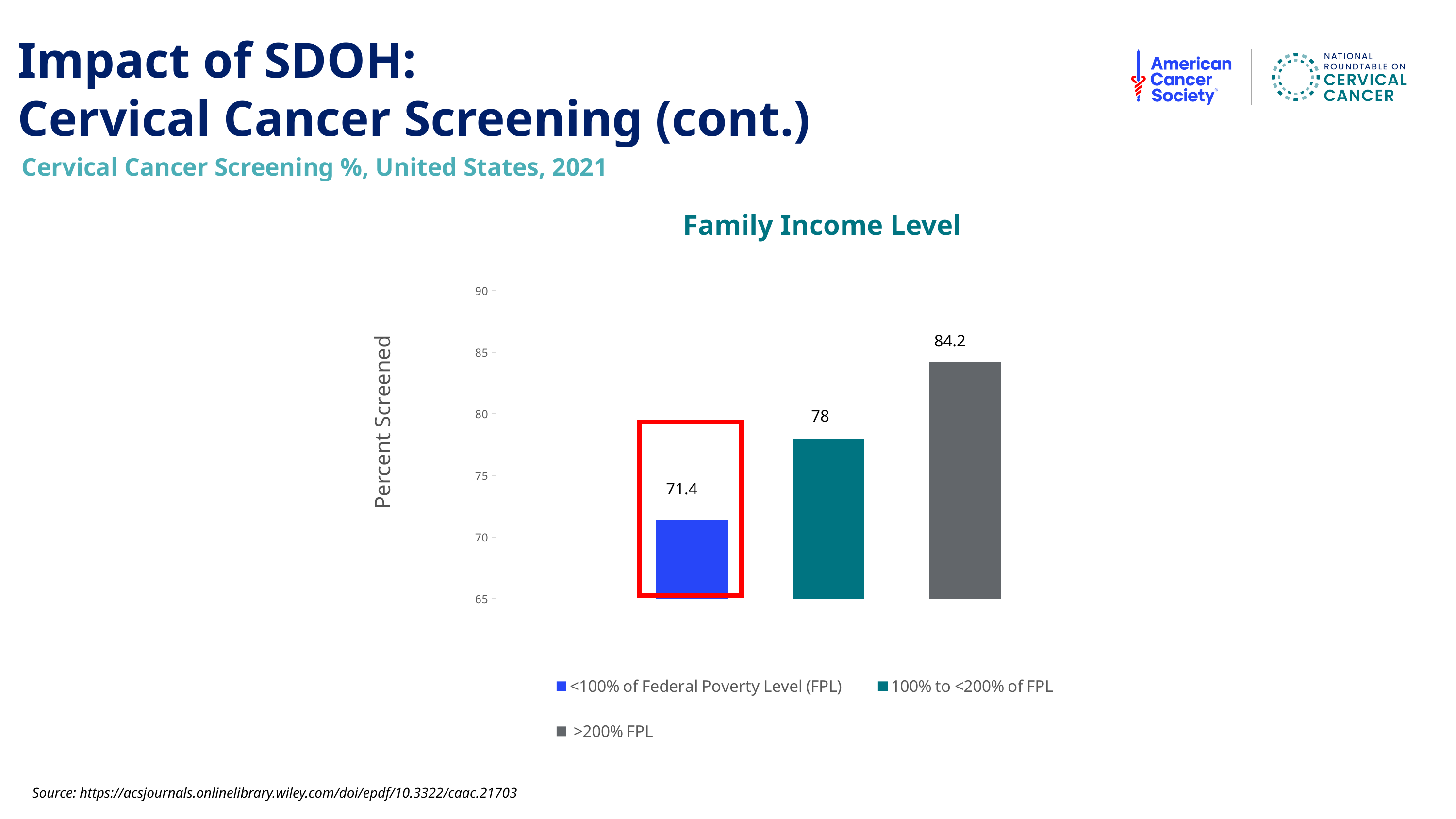
What is the percent screened for the 100% to <200% of FPL group? 78 How many family income level groups are shown in the chart? 3 Is the percent screened for the 100% to <200% of FPL group greater or less than 75? greater What is the difference in percent screened between the 100% to <200% of FPL group and the <100% of Federal Poverty Level (FPL) group? 6.6 What is the title of the chart? Family Income Level What kind of chart is shown on the slide? Bar chart Which family income level group has the highest percent screened? >200% FPL Which family income level group has the lowest percent screened? <100% of Federal Poverty Level (FPL) What is the percent screened for the >200% FPL group? 84.2 What is the difference in percent screened between the >200% FPL group and the <100% of Federal Poverty Level (FPL) group? 12.8 Which has a higher percent screened: the 100% to <200% of FPL group or the >200% FPL group? >200% FPL What is the percent screened for the <100% of Federal Poverty Level (FPL) group? 71.4